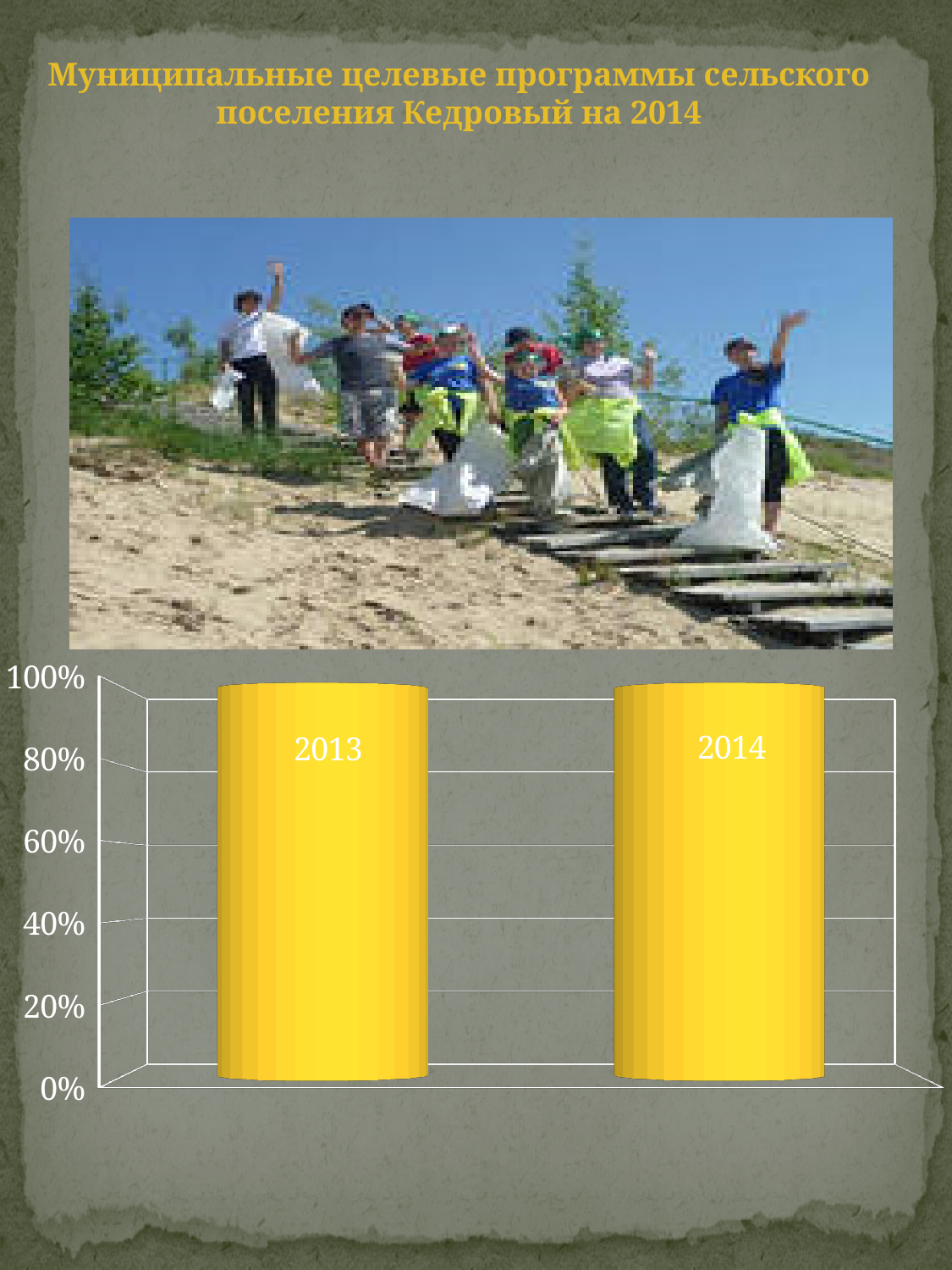
How many bars are plotted in the chart? 2 What is the highest value shown on the vertical axis of the chart? 100% What kind of chart is shown on the slide? bar chart Is the value for 2013 greater or less than 80%? greater What are the labels of the two bars in the chart? 2013 and 2014 Is the value for 2014 greater or less than 80%? greater Is the value for 2014 greater or less than 40%? greater